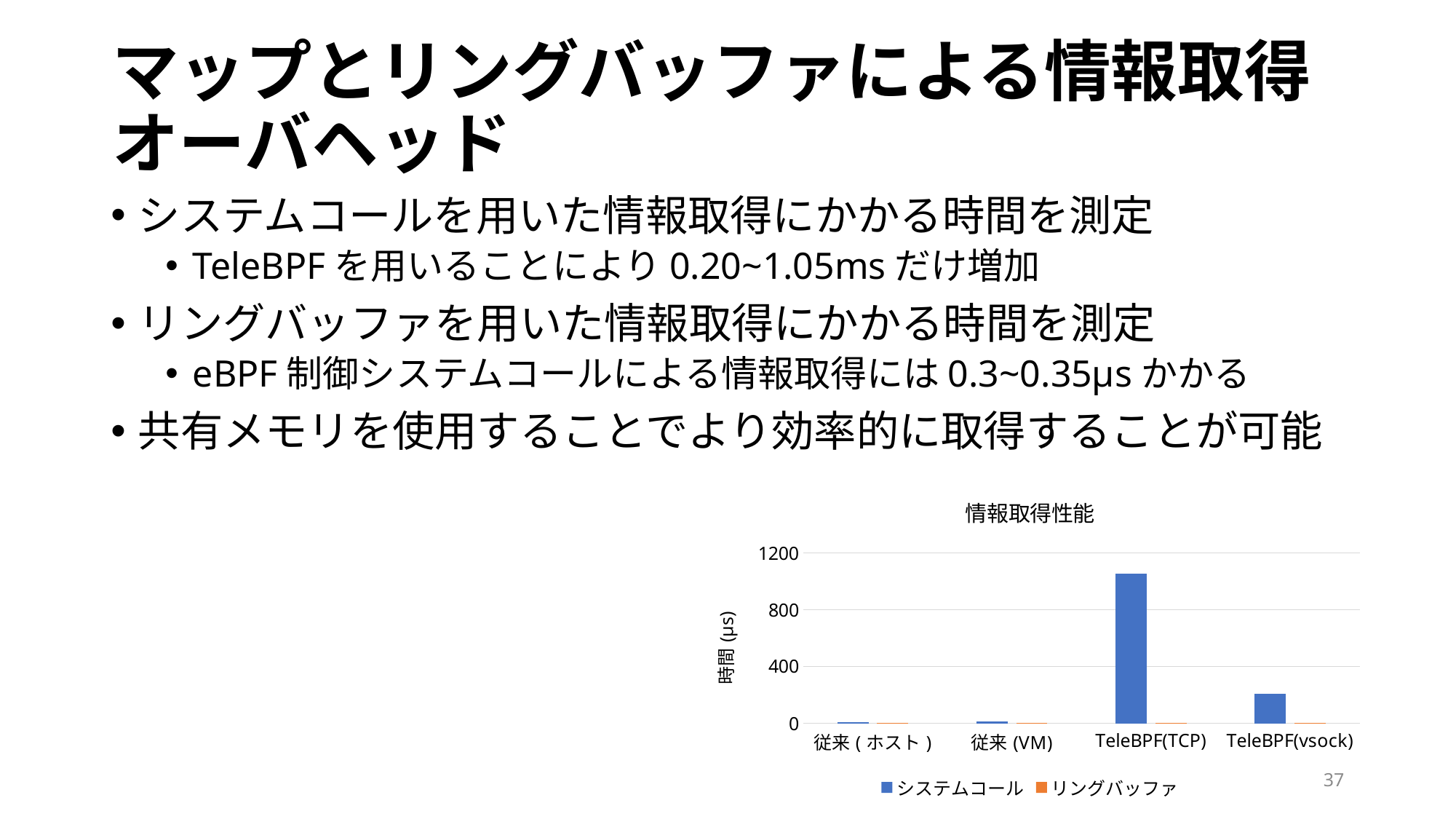
Which has the larger システムコール value, TeleBPF(TCP) or TeleBPF(vsock)? TeleBPF(TCP) What kind of chart is shown on the slide? bar chart Is the システムコール value for TeleBPF(TCP) greater or less than 800? greater Is the システムコール value for 従来 (VM) greater or less than 400? less Which category has the highest システムコール value? TeleBPF(TCP) How many series does the chart's legend list? 2 How many categories are shown on the x axis of the chart? 4 What is the title of the chart? 情報取得性能 Which has the larger システムコール value, 従来 (VM) or TeleBPF(vsock)? TeleBPF(vsock) What is the label of the vertical axis of the chart? 時間 (μs) Is the システムコール value for TeleBPF(vsock) greater or less than 400? less